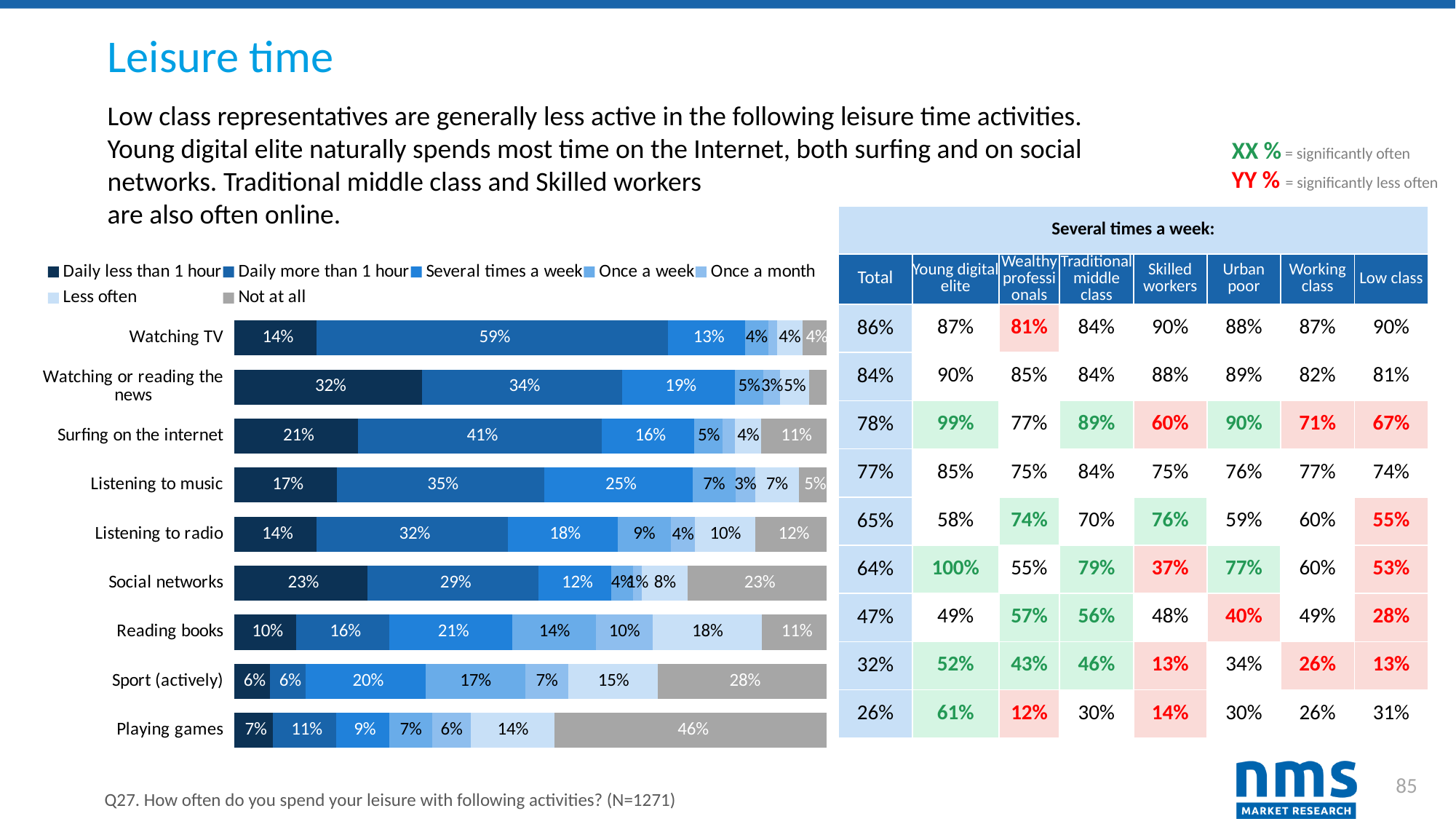
In the bar chart, what is the 'Daily more than 1 hour' value for Watching TV? 59% What kind of chart is shown on the left of the slide? Stacked bar chart In the bar chart, what colour represents the 'Not at all' series? Grey How many series does the legend of the bar chart list? 7 In the bar chart, what is the difference between the 'Not at all' values for Sport (actively) and Social networks? 5 percentage points In the bar chart, what is the 'Daily less than 1 hour' value for Watching or reading the news? 32% In the bar chart, which has the larger 'Daily more than 1 hour' value: Surfing on the internet or Listening to music? Surfing on the internet In the bar chart, what is the 'Several times a week' value for Reading books? 21% In the bar chart, which activity has the highest 'Not at all' share? Playing games In the bar chart, which activity has the highest 'Daily less than 1 hour' value? Watching or reading the news How many leisure activities are listed as categories in the bar chart? 9 In the bar chart, what is the 'Not at all' value for Playing games? 46%